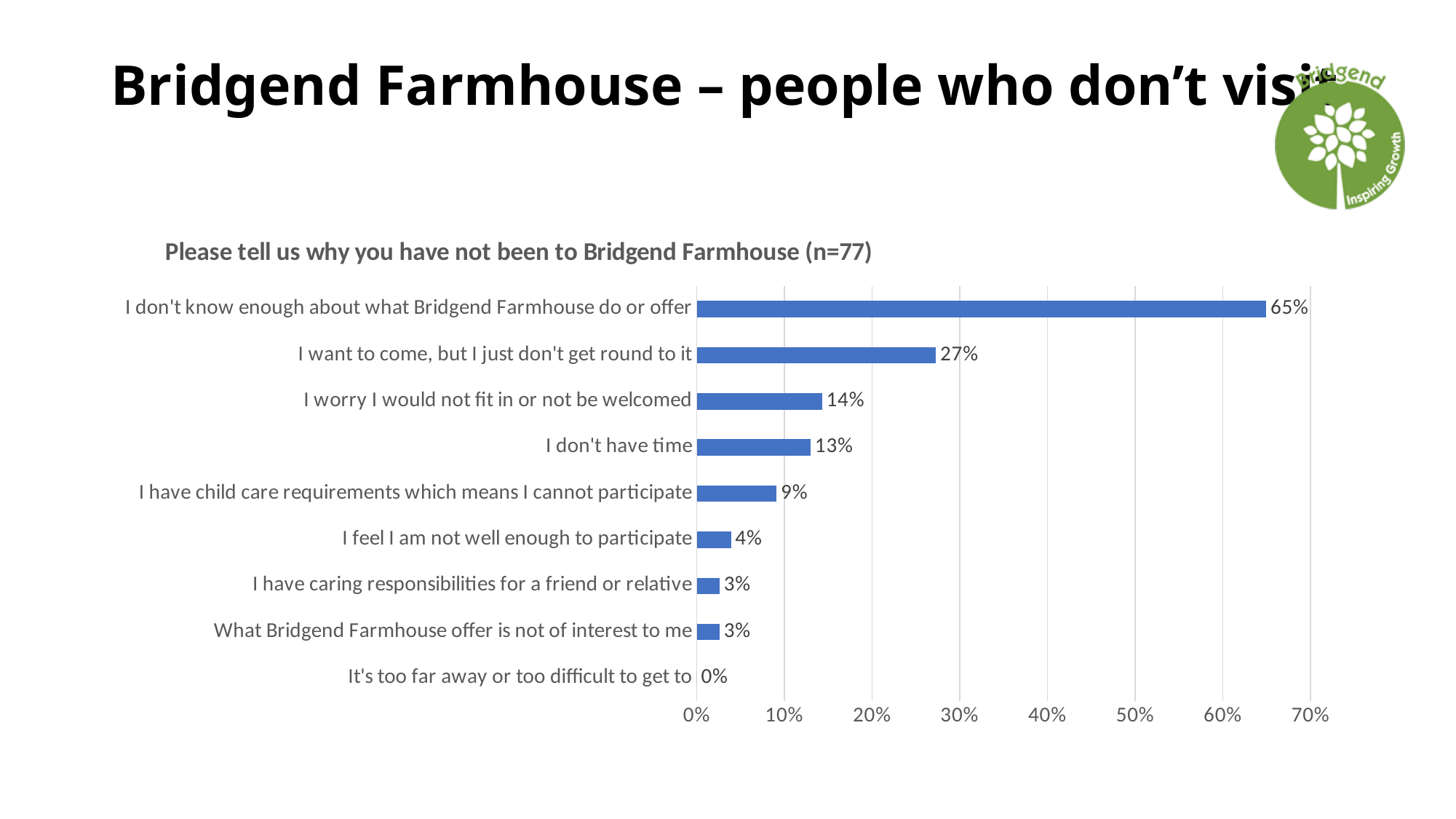
What percentage of respondents said "I don't know enough about what Bridgend Farmhouse do or offer"? 65% What kind of chart is shown on the slide? Bar chart What is the value for "It's too far away or too difficult to get to"? 0% What is the title of the chart? Please tell us why you have not been to Bridgend Farmhouse (n=77) Is the value for "I want to come, but I just don't get round to it" greater or less than 20%? greater Which reason has the lowest percentage? It's too far away or too difficult to get to What percentage of respondents said "I don't have time"? 13% What is the difference between "I don't know enough about what Bridgend Farmhouse do or offer" and "I want to come, but I just don't get round to it"? 38% How many reasons are listed in the chart? 9 Which reason has the highest percentage? I don't know enough about what Bridgend Farmhouse do or offer What is the value for "I want to come, but I just don't get round to it"? 27% Which is larger: "I worry I would not fit in or not be welcomed" or "I have child care requirements which means I cannot participate"? I worry I would not fit in or not be welcomed